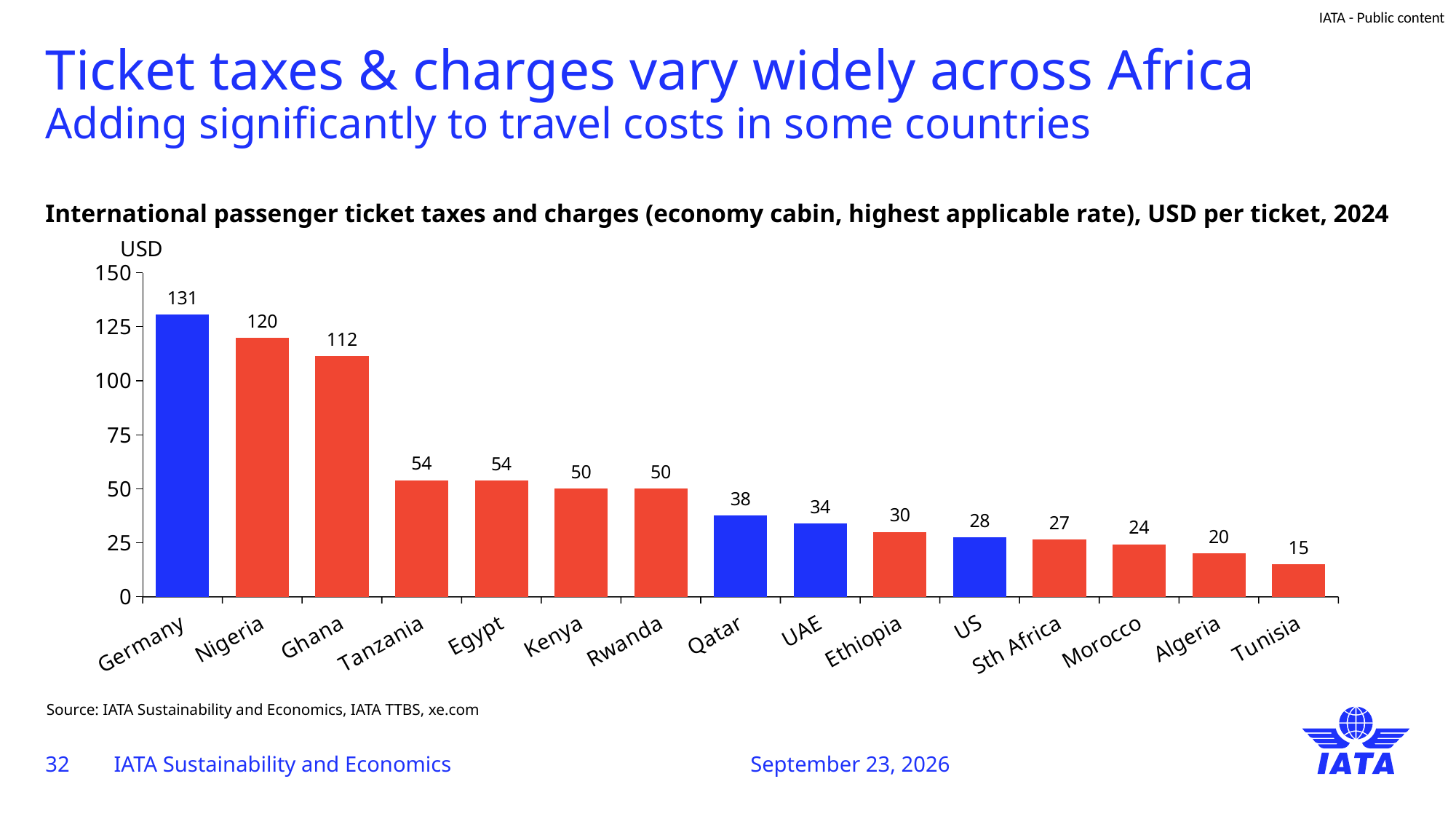
What is the value for Qatar? 38 What is the value for Nigeria? 120 What kind of chart is shown on the slide? bar chart What unit is shown on the vertical axis of the chart? USD Is the value for Ghana greater or less than 100? greater How many countries are shown on the chart? 15 Which country has the highest value? Germany What is the difference between the values for Tanzania and Tunisia? 39 Which country has the lowest value? Tunisia What is the value for Sth Africa? 27 What is the difference between the values for Germany and Ghana? 19 Which is larger, the value for UAE or the value for Ethiopia? UAE